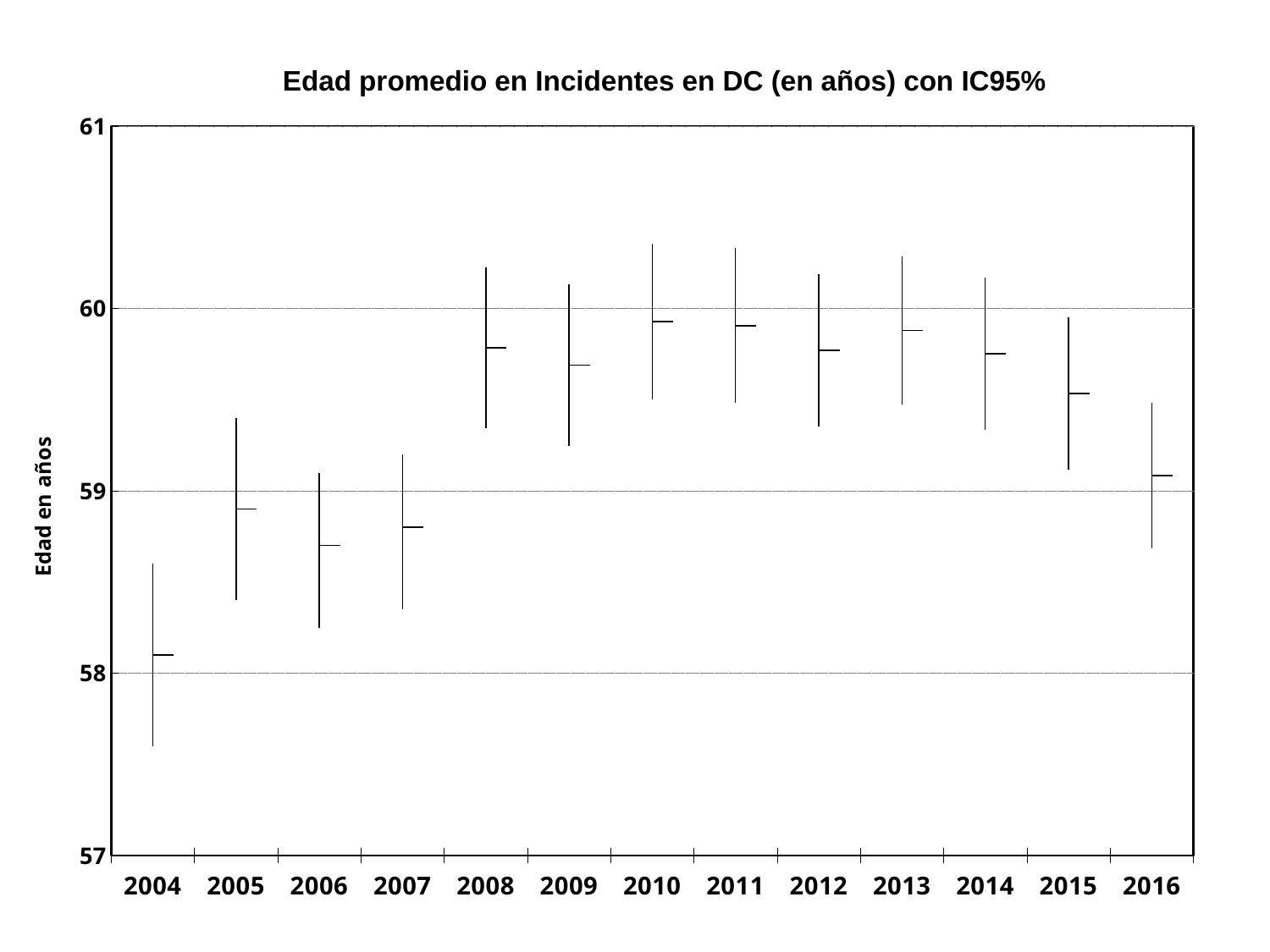
Does the average age rise or fall from 2004 to 2008? rise Is the average age for 2010 greater or less than 59? greater Is the average age for 2004 greater or less than 59? less Is the average age for 2006 greater or less than 59? less What is the title of the chart? Edad promedio en Incidentes en DC (en años) con IC95% Which year has a higher average age, 2015 or 2016? 2015 Which year has the lowest average age? 2004 How many years are shown on the horizontal axis? 13 Which year has a higher average age, 2004 or 2005? 2005 What is the label of the vertical axis? Edad en años